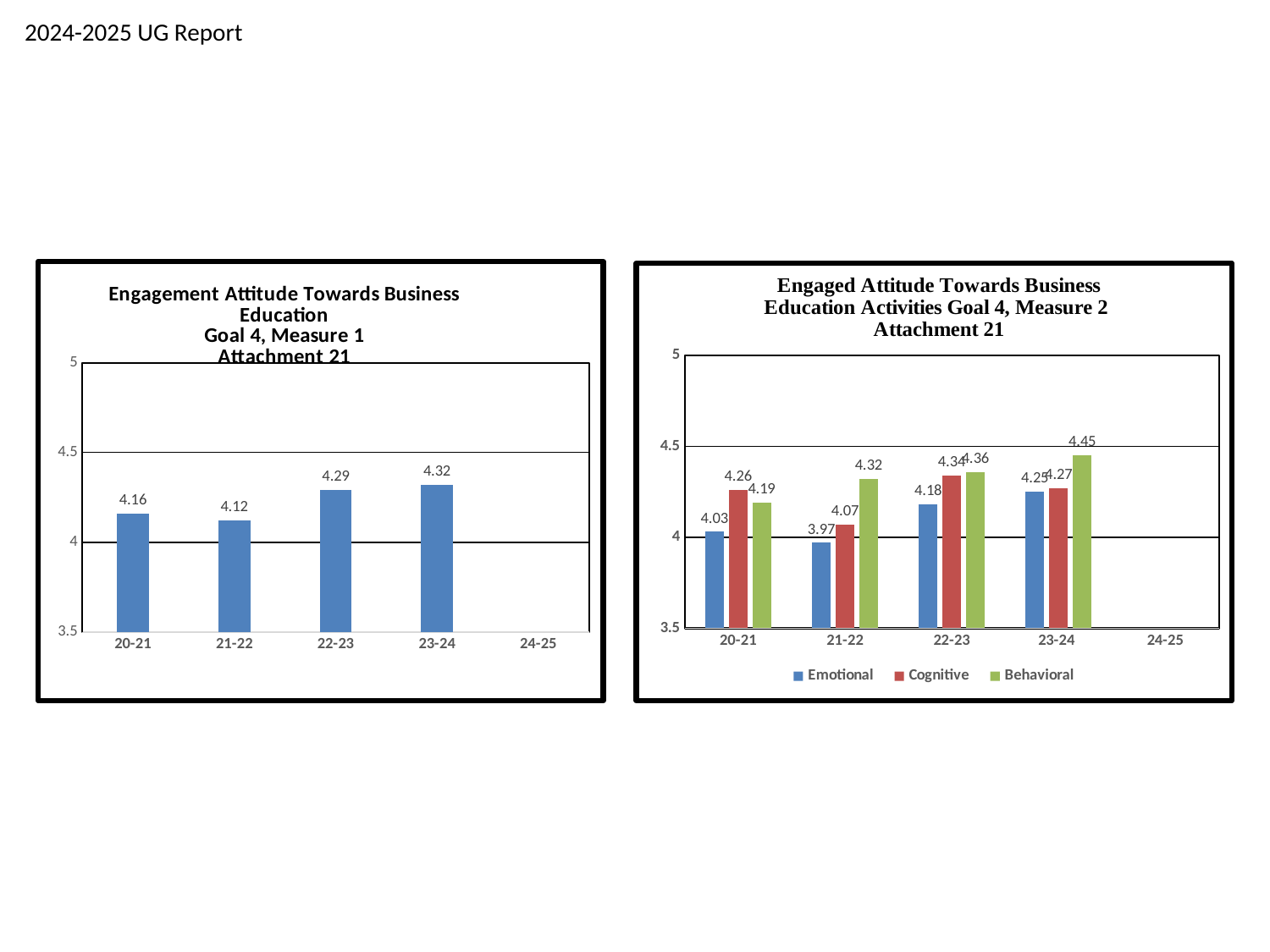
In the left chart (Goal 4, Measure 1), what is the value for 22-23? 4.29 What kind of chart is the left chart (Goal 4, Measure 1)? Bar chart In the left chart (Goal 4, Measure 1), how many years have a bar plotted? 4 In the right chart (Goal 4, Measure 2), which is larger for 20-21: Cognitive or Behavioral? Cognitive In the right chart (Goal 4, Measure 2), what is the Emotional value for 21-22? 3.97 In the left chart (Goal 4, Measure 1), what is the difference between the 23-24 value and the 20-21 value? 0.16 In the right chart (Goal 4, Measure 2), is the Emotional value for 21-22 greater or less than 4? less In the right chart (Goal 4, Measure 2), what is the Behavioral value for 23-24? 4.45 In the right chart (Goal 4, Measure 2), what is the difference between the Behavioral and Emotional values for 21-22? 0.35 In the right chart (Goal 4, Measure 2), how many series does the legend list? 3 In the right chart (Goal 4, Measure 2), which series is shown in green? Behavioral In the left chart (Goal 4, Measure 1), which year has the lowest value? 21-22